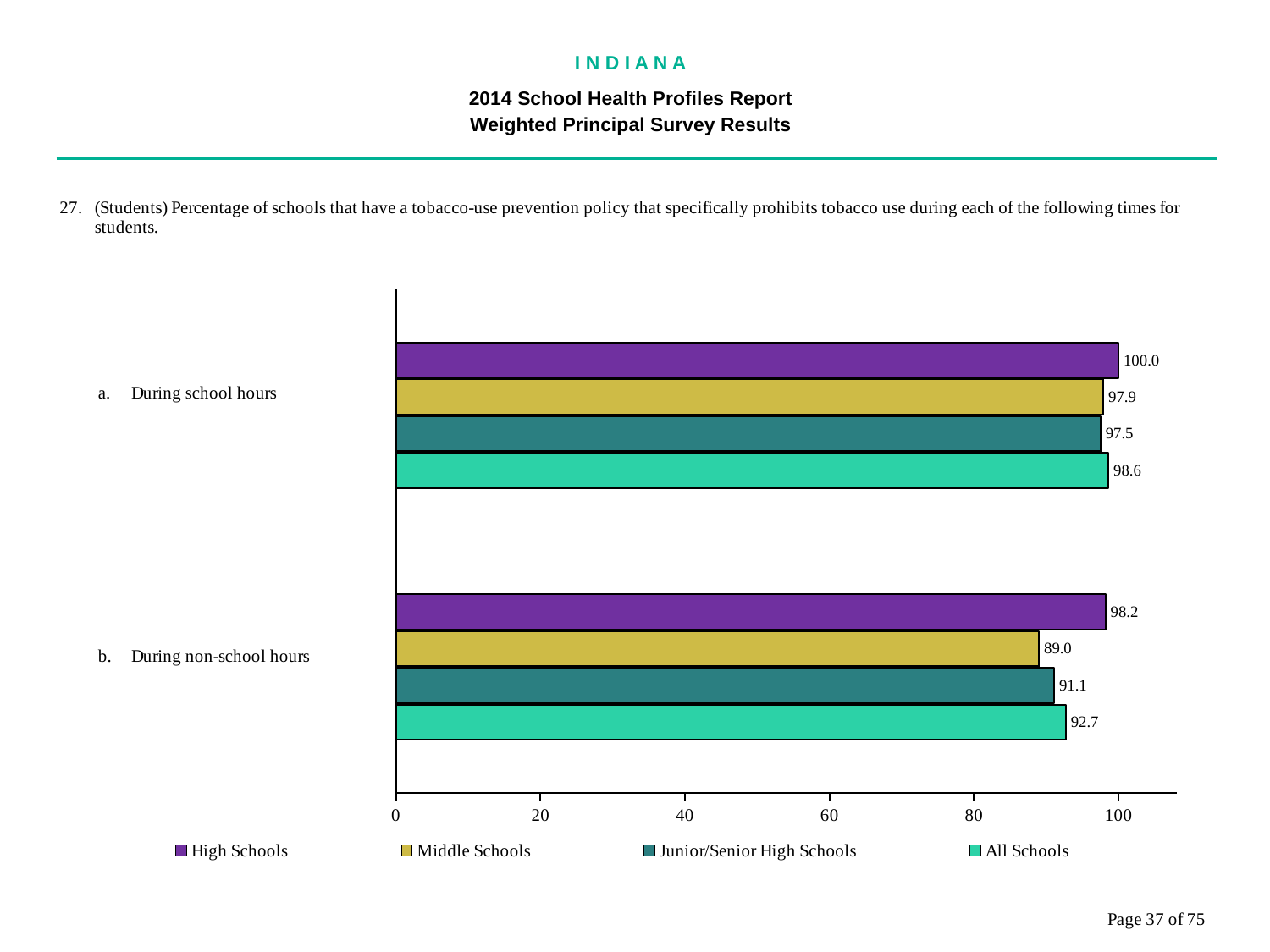
What is the difference between the Middle Schools values during school hours and during non-school hours? 8.9 Which school type has the highest value during school hours? High Schools Which school type has the lowest value during non-school hours? Middle Schools What is the difference between the High Schools values during school hours and during non-school hours? 1.8 What kind of chart is shown on the slide? Bar chart What is the value for High Schools during school hours? 100.0 How many series does the legend list? 4 What is the value for Middle Schools during non-school hours? 89.0 Which is larger: the All Schools value during non-school hours or the Junior/Senior High Schools value during non-school hours? All Schools What is the value for All Schools during school hours? 98.6 What is the value for Junior/Senior High Schools during non-school hours? 91.1 Which legend entry is shown in purple? High Schools